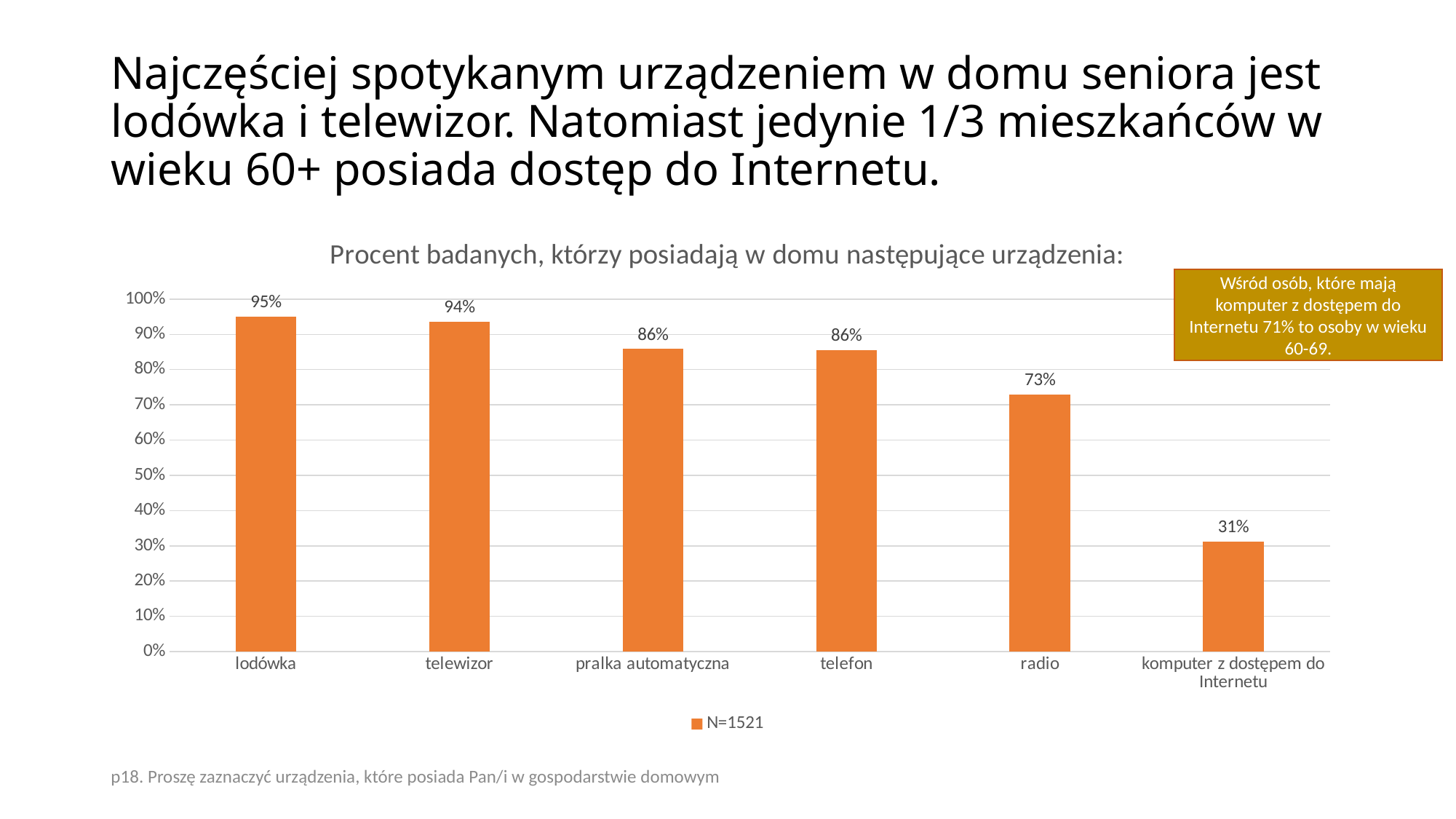
What is the legend entry shown below the chart? N=1521 What percentage of respondents have a lodówka at home? 95% How many device categories are shown in the chart? 6 What is the value shown for radio? 73% What is the difference in percentage points between lodówka and komputer z dostępem do Internetu? 64 Which is larger, the value for telewizor or the value for radio? telewizor Is the value for radio greater or less than 70%? greater Which device has the lowest percentage in the chart? komputer z dostępem do Internetu What percentage of respondents have a komputer z dostępem do Internetu? 31% What type of chart is shown on the slide? bar chart Which device has the highest percentage in the chart? lodówka What is the difference in percentage points between telewizor and radio? 21